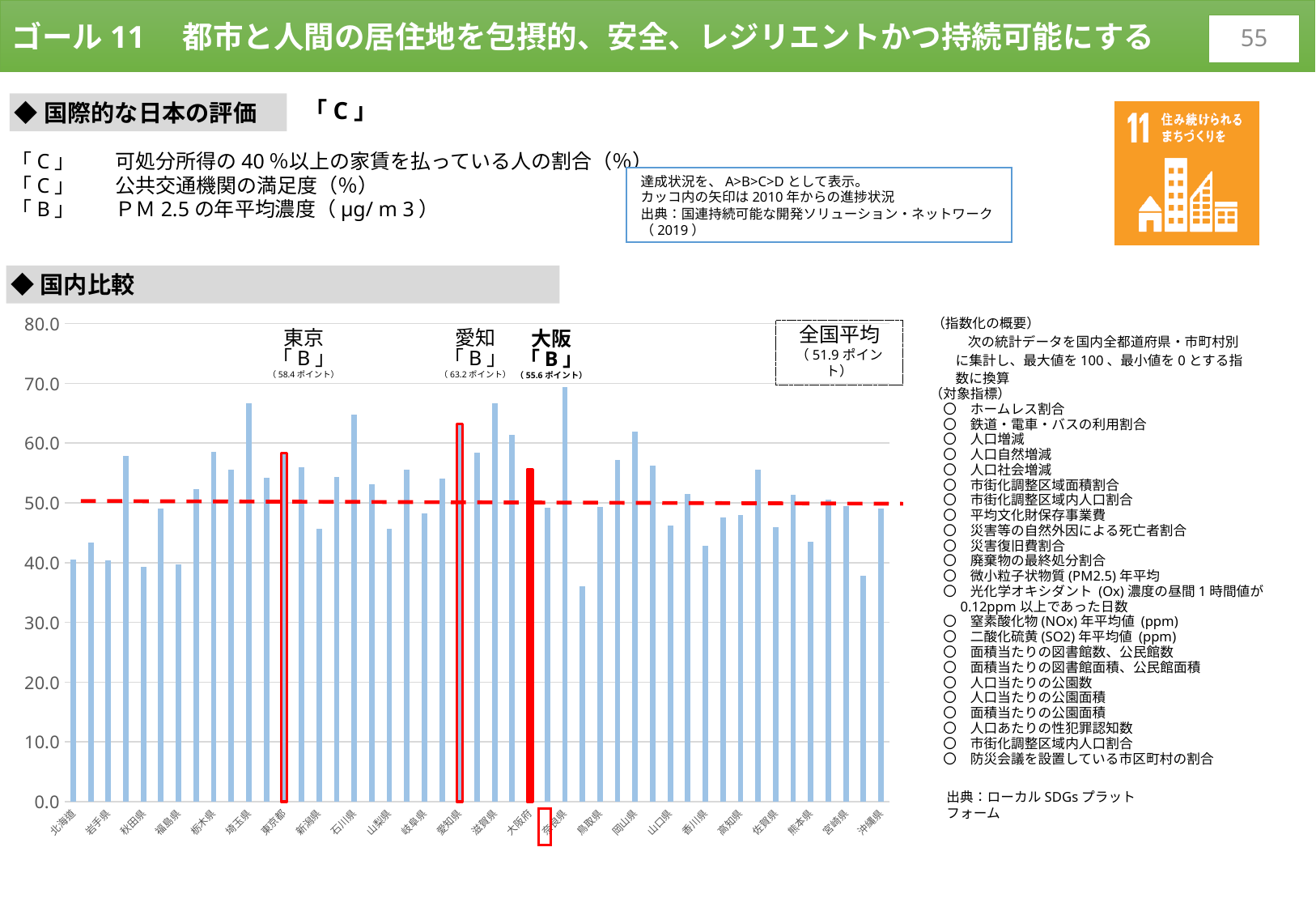
What is the value shown for 愛知 on the 国内比較 bar chart? 63.2 ポイント On the 国内比較 chart, is the value for 鳥取県 greater or less than 40.0? greater On the 国内比較 chart, is the value for 北海道 greater or less than 50.0? less On the 国内比較 chart, what is the difference between the values for 愛知 and 東京? 4.8 ポイント On the 国内比較 chart, is the value for 埼玉県 greater or less than 60.0? greater What kind of chart is used in the 国内比較 section? bar chart What is the value shown for 東京 on the 国内比較 bar chart? 58.4 ポイント On the 国内比較 chart, which has the larger value, 東京 or 愛知? 愛知 What is the 全国平均 value shown on the 国内比較 bar chart? 51.9 ポイント What is the value shown for 大阪 on the 国内比較 bar chart? 55.6 ポイント On the 国内比較 chart, how much higher is 大阪 than the 全国平均? 3.7 ポイント